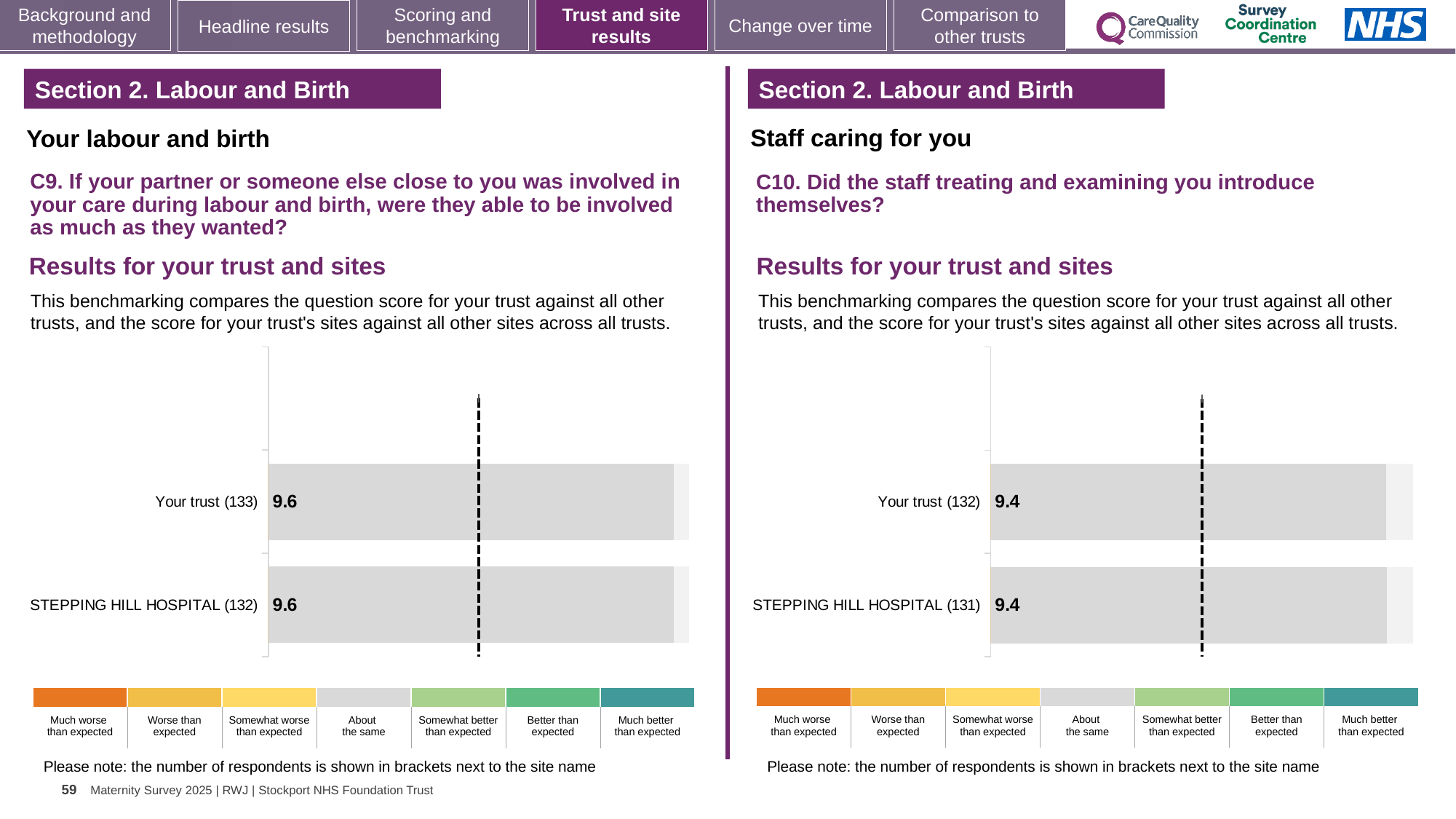
In the C9 chart on the left, what is the score for STEPPING HILL HOSPITAL (132)? 9.6 How many bars are plotted in the C10 chart on the right? 2 In the C10 chart on the right, what is the score for STEPPING HILL HOSPITAL (131)? 9.4 How many categories does the colour key below the C10 chart on the right list? 7 How many bars are plotted in the C9 chart on the left? 2 In the C10 chart on the right, what is the difference between the score for Your trust and the score for STEPPING HILL HOSPITAL? 0.0 In the C9 chart on the left, what is the score for Your trust (133)? 9.6 In the C9 chart on the left, how many respondents are shown in brackets for STEPPING HILL HOSPITAL? 132 In the C9 chart on the left, what is the difference between the score for Your trust and the score for STEPPING HILL HOSPITAL? 0.0 What kind of chart is used in the C9 chart on the left? Bar chart In the C10 chart on the right, what is the score for Your trust (132)? 9.4 In the C10 chart on the right, which category of the colour key does the grey colour of the bars correspond to? About the same